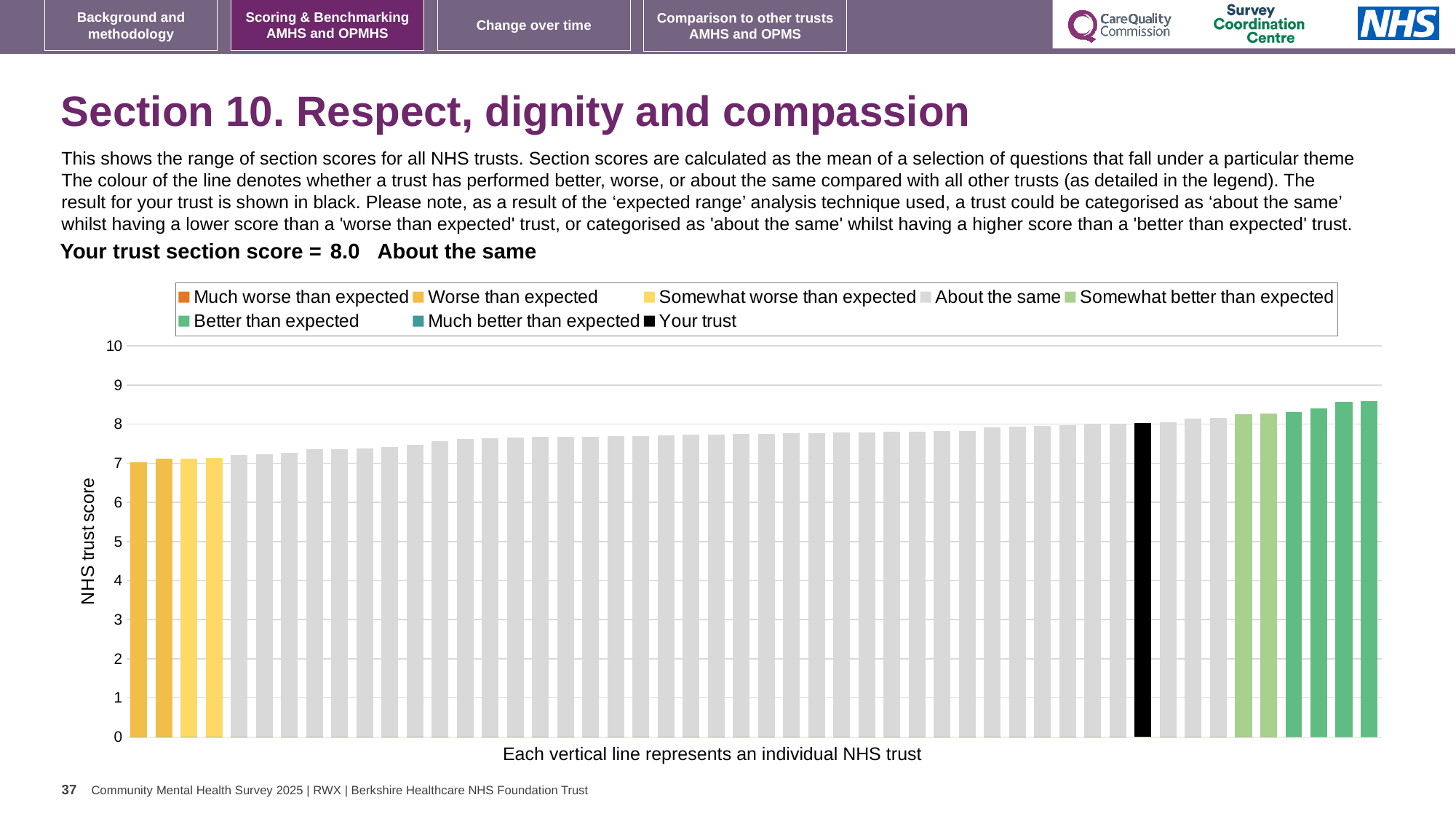
Which category is your trust placed in for this section? About the same What is the section score for your trust shown on the slide? 8.0 How many entries does the chart legend list? 8 What colour is the bar representing your trust? black Is the value of the rightmost bar greater or less than 9? less Which is higher, the leftmost bar or the rightmost bar? the rightmost bar Is the value of the leftmost bar greater or less than 8? less What kind of chart is shown on the slide? bar chart Is the value of the rightmost bar greater or less than 8? greater What is the label on the vertical axis of the chart? NHS trust score Do the bar values rise or fall from left to right along the x axis? rise